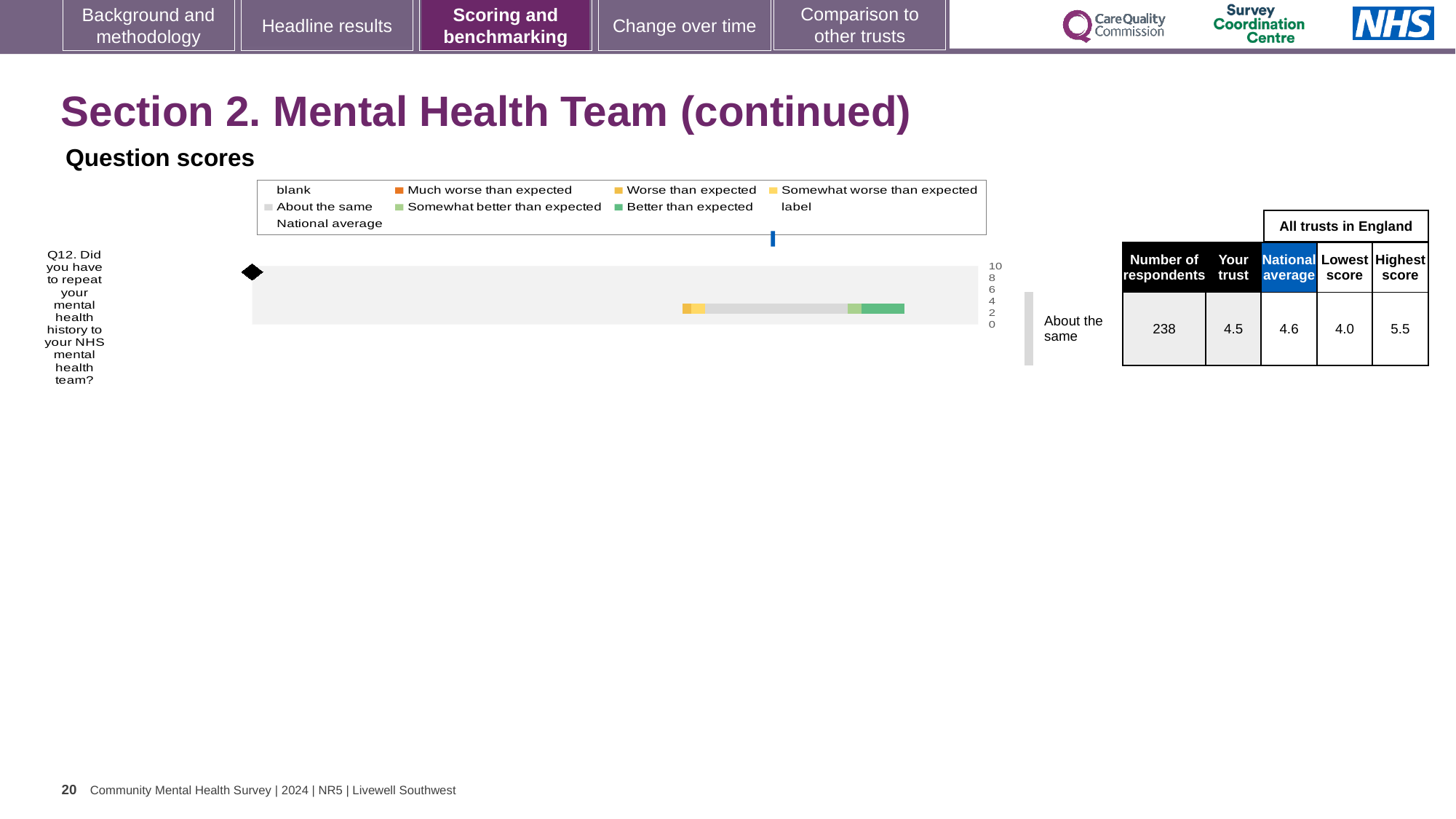
What is the difference between the Highest score and the Lowest score for Q12 in the table? 1.5 In the table next to the chart, what is the National average score for Q12? 4.6 Which question is plotted on the chart? Q12. Did you have to repeat your mental health history to your NHS mental health team? In the table next to the chart, what is the Lowest score among all trusts in England for Q12? 4.0 In the table next to the chart, how many respondents answered Q12? 238 What benchmark category label is shown to the right of the Q12 bar? About the same What kind of chart is used to show the Q12 question score? bar chart In the table next to the chart, what is the 'Your trust' score for Q12? 4.5 How many questions (categories) are plotted on the chart? 1 In the table next to the chart, what is the Highest score among all trusts in England for Q12? 5.5 Which is larger for Q12, the 'Your trust' score or the National average? National average